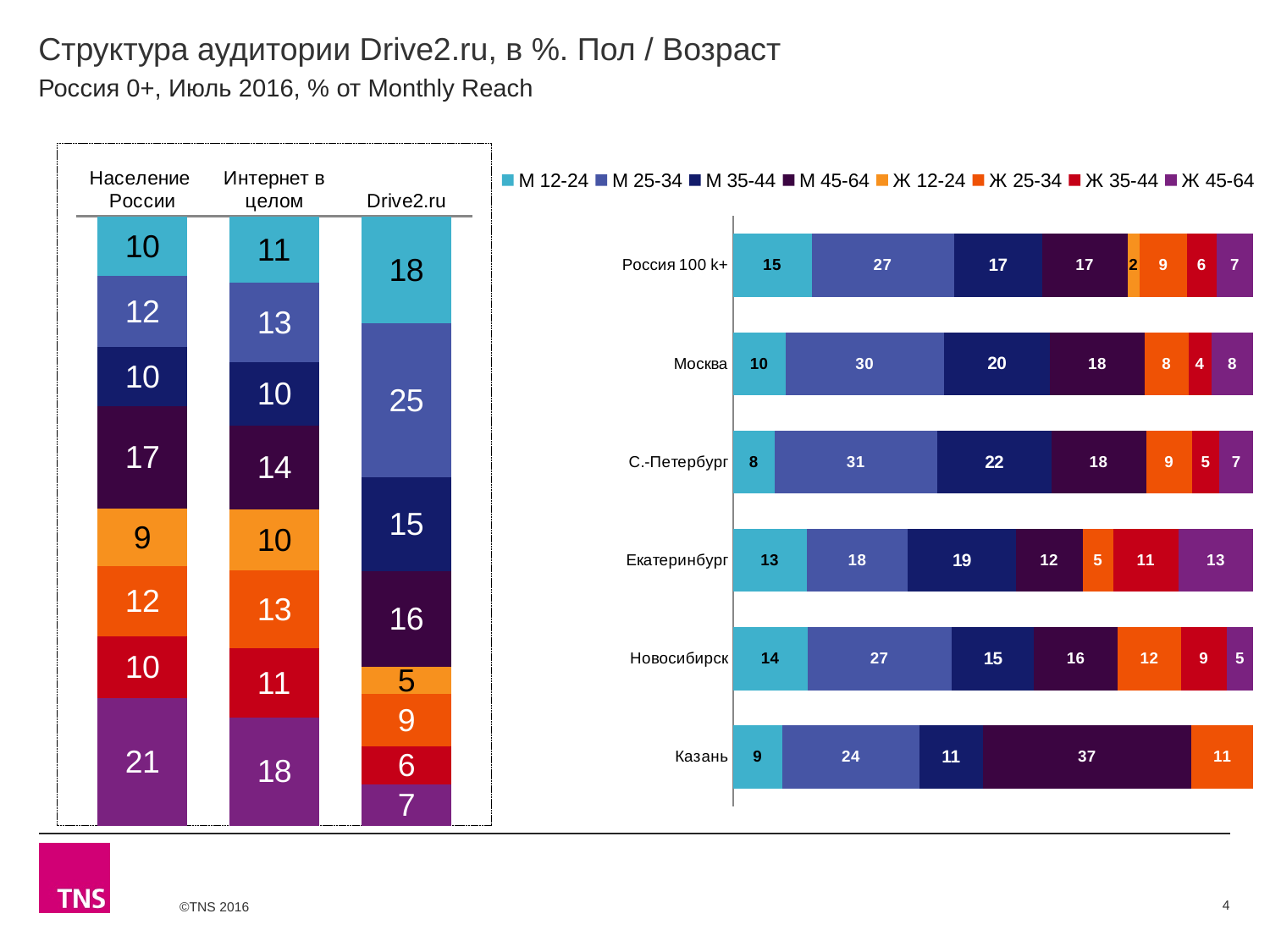
In the right chart, what is the value of the М 25-34 segment for С.-Петербург? 31 In the right chart, which city has the largest М 25-34 segment? С.-Петербург How many series does the legend list? 8 In the left chart, what is the value of the М 25-34 segment for Drive2.ru? 25 In the left chart, what is the difference between the Ж 45-64 values for Население России and Drive2.ru? 14 In the left chart, what is the value of the Ж 45-64 segment for Население России? 21 In the right chart, what is the value of the М 45-64 segment for Казань? 37 In the left chart, which of the three bars has the largest М 12-24 segment? Drive2.ru In the left chart, what is the value of the М 45-64 segment for Интернет в целом? 14 In the right chart, is the М 35-44 value larger for Москва or for Новосибирск? Москва What type of chart is the right chart? Stacked bar chart In the right chart, how many cities/regions are shown? 6